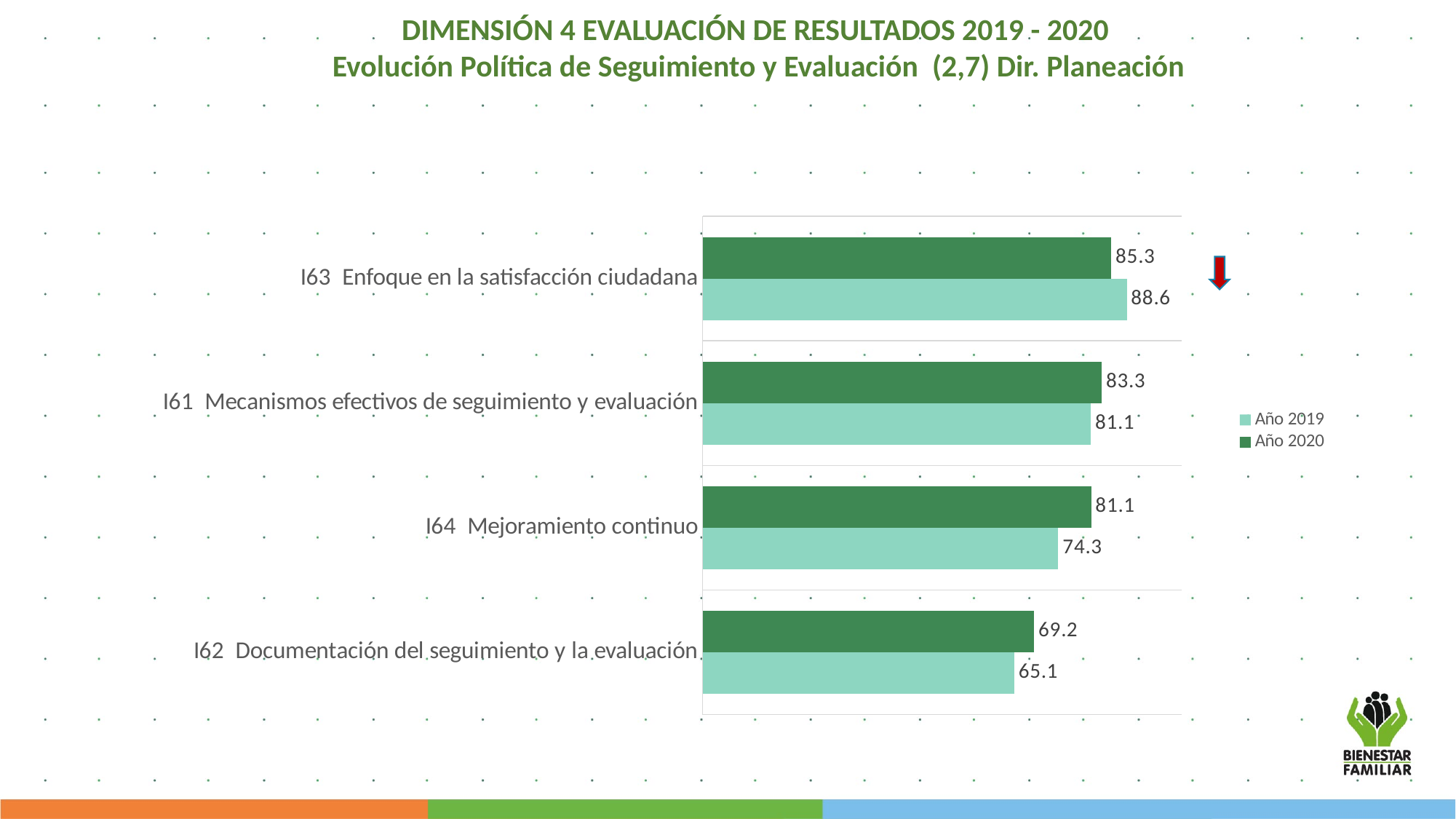
What is the difference between the Año 2019 and Año 2020 values for I64 Mejoramiento continuo? 6.8 What is the Año 2020 value for I63 Enfoque en la satisfacción ciudadana? 85.3 What is the Año 2019 value for I62 Documentación del seguimiento y la evaluación? 65.1 What is the difference between the Año 2019 and Año 2020 values for I63 Enfoque en la satisfacción ciudadana? 3.3 How many categories are shown on the chart? 4 How many series does the legend list? 2 Which category has the lowest Año 2020 value? I62 Documentación del seguimiento y la evaluación For I63 Enfoque en la satisfacción ciudadana, which year has the larger value, Año 2019 or Año 2020? Año 2019 What kind of chart is shown on the slide? Bar chart For I61 Mecanismos efectivos de seguimiento y evaluación, which year has the larger value, Año 2019 or Año 2020? Año 2020 Which category has the highest Año 2019 value? I63 Enfoque en la satisfacción ciudadana What is the Año 2019 value for I64 Mejoramiento continuo? 74.3